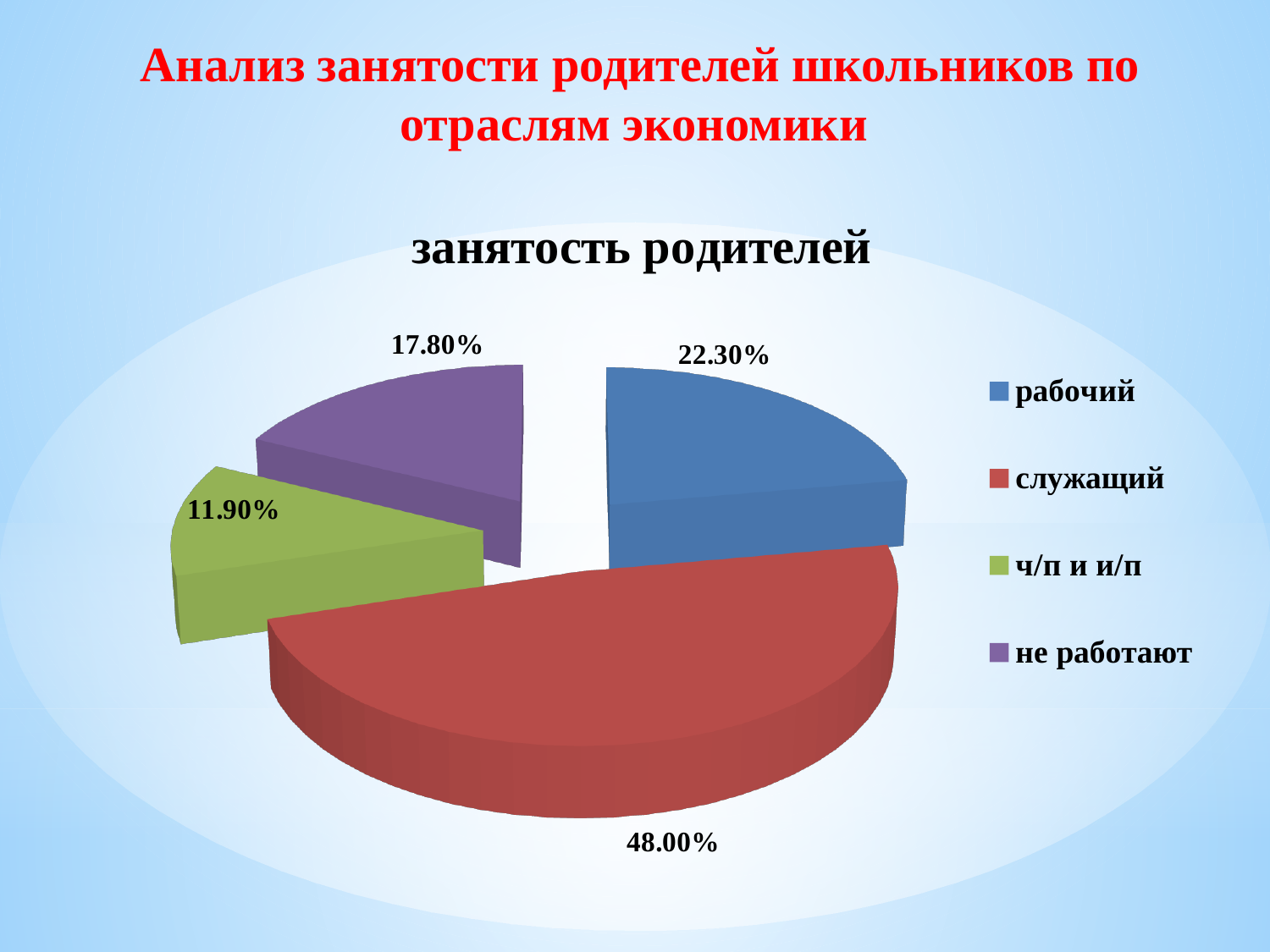
What is the difference in percentage points between 'служащий' and 'рабочий'? 25.70 Which category has the largest share of the pie? служащий What percentage is shown for the category 'ч/п и и/п'? 11.90% What percentage of the pie is labelled for the category 'служащий'? 48.00% What percentage is shown for the category 'не работают'? 17.80% What is the title of the chart? занятость родителей What type of chart is shown on the slide? pie chart Which is larger: the share for 'рабочий' or the share for 'не работают'? рабочий Which colour represents the category 'не работают' in the legend? purple How many categories does the pie chart have? 4 What percentage is shown for the category 'рабочий'? 22.30% Which category has the smallest share of the pie? ч/п и и/п